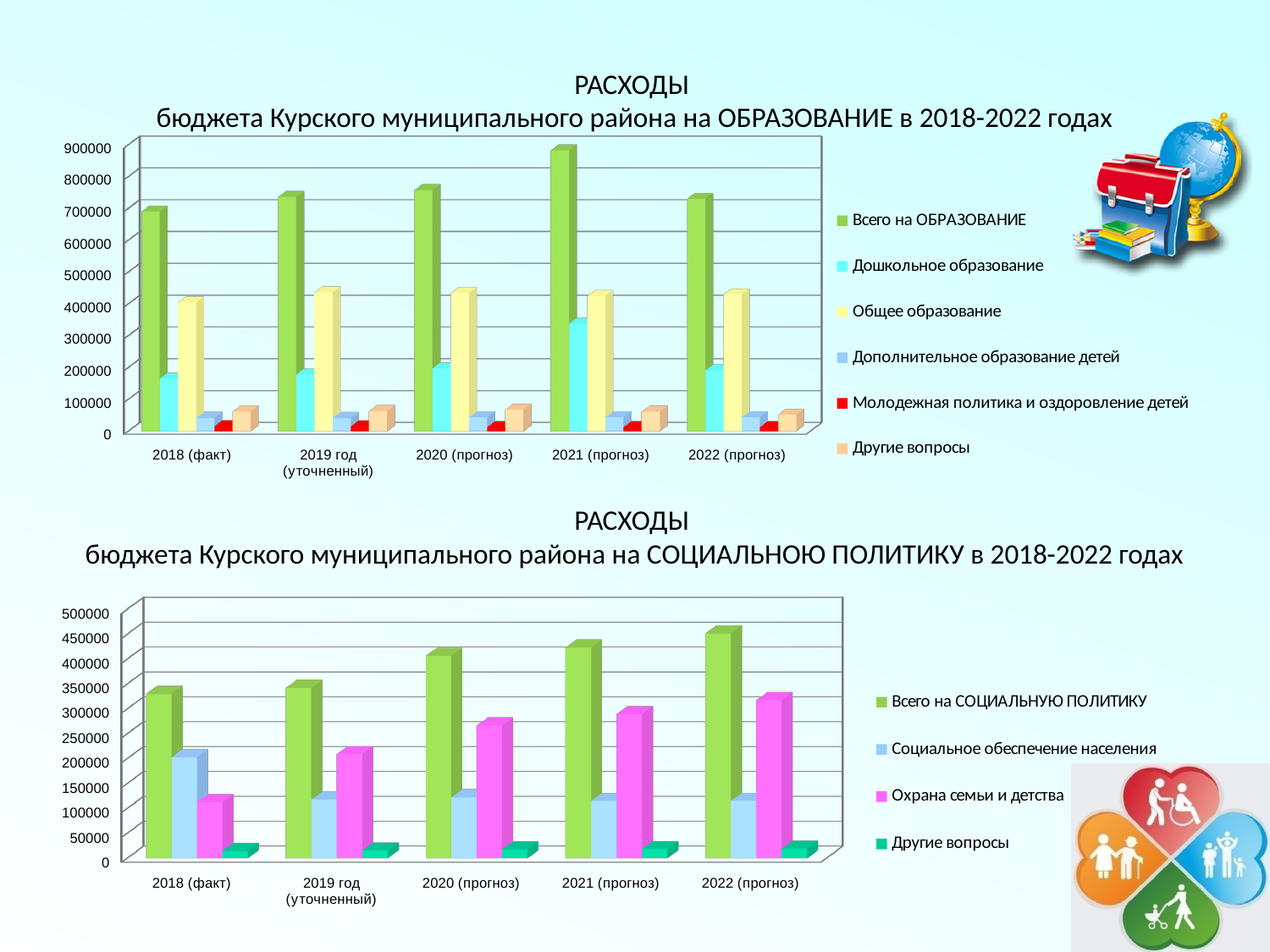
In the bottom chart (СОЦИАЛЬНАЯ ПОЛИТИКА), do the values for Всего на СОЦИАЛЬНУЮ ПОЛИТИКУ rise or fall from 2018 to 2022? rise In the top chart (ОБРАЗОВАНИЕ), which is larger in 2018 (факт): Общее образование or Дошкольное образование? Общее образование What type of chart is the top chart about expenditures on ОБРАЗОВАНИЕ? bar chart In the top chart (ОБРАЗОВАНИЕ), is the value for Дошкольное образование in 2021 (прогноз) greater or less than 300000? greater In the bottom chart (СОЦИАЛЬНАЯ ПОЛИТИКА), how many series does the legend list? 4 In the top chart (ОБРАЗОВАНИЕ), how many year categories are shown on the x axis? 5 In the top chart (ОБРАЗОВАНИЕ), in which year is the value for Всего на ОБРАЗОВАНИЕ the highest? 2021 (прогноз) In the bottom chart (СОЦИАЛЬНАЯ ПОЛИТИКА), which colour represents Охрана семьи и детства in the legend? pink (magenta) In the top chart (ОБРАЗОВАНИЕ), is the value for Всего на ОБРАЗОВАНИЕ in 2021 (прогноз) greater or less than 800000? greater In the bottom chart (СОЦИАЛЬНАЯ ПОЛИТИКА), which is larger in 2018 (факт): Социальное обеспечение населения or Охрана семьи и детства? Социальное обеспечение населения In the top chart (ОБРАЗОВАНИЕ), how many series does the legend list? 6 In the bottom chart (СОЦИАЛЬНАЯ ПОЛИТИКА), is the value for Всего на СОЦИАЛЬНУЮ ПОЛИТИКУ in 2022 (прогноз) greater or less than 400000? greater